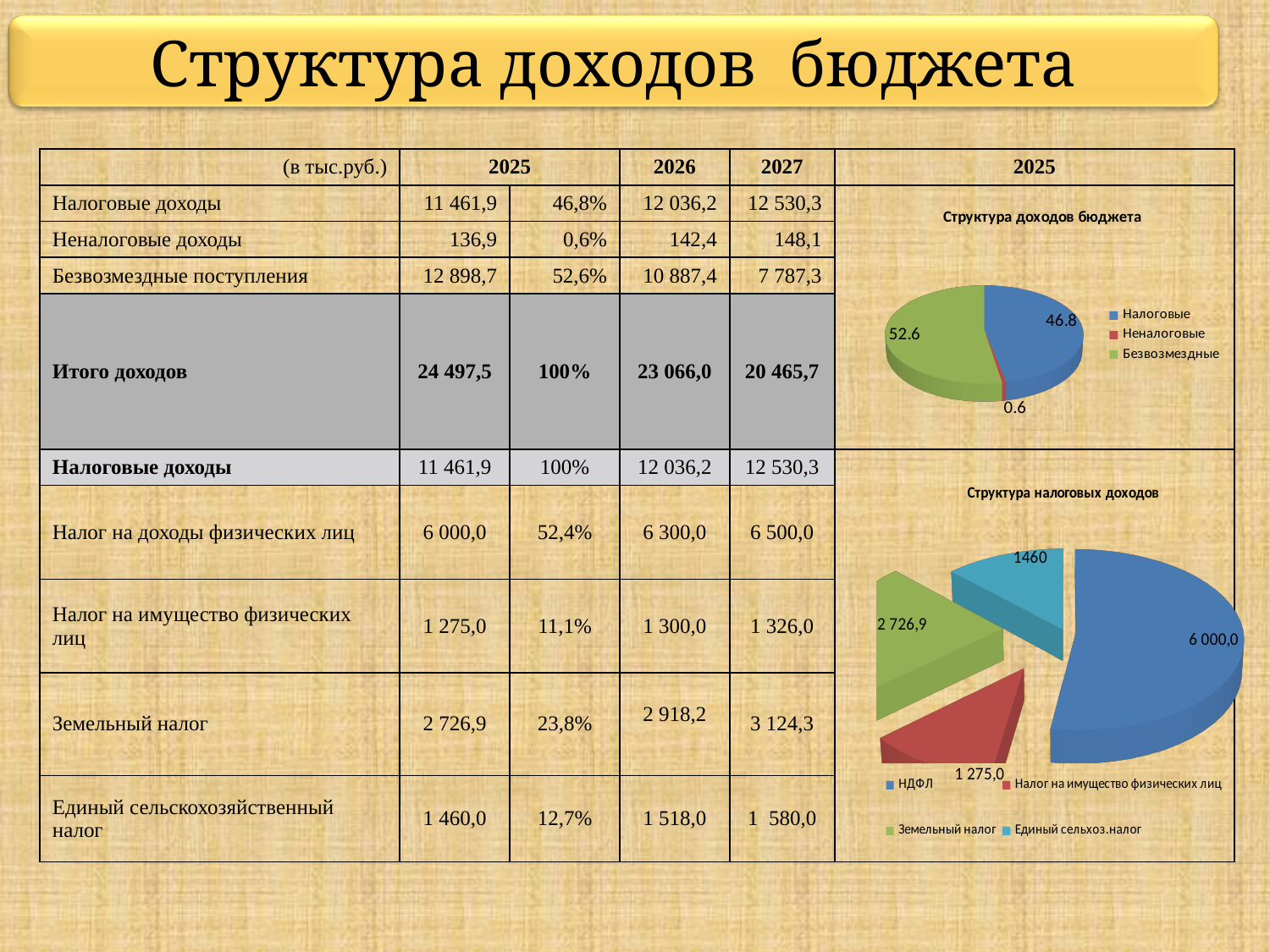
In the "Структура налоговых доходов" chart, what value is shown for the НДФЛ slice? 6 000,0 In the "Структура налоговых доходов" chart, what value is shown for the Земельный налог slice? 2 726,9 In the "Структура налоговых доходов" chart, what value is shown for the Налог на имущество физических лиц slice? 1 275,0 In the "Структура доходов бюджета" chart, what value is shown for the Безвозмездные slice? 52.6 What type of chart is the "Структура доходов бюджета" chart? pie chart In the "Структура доходов бюджета" chart, which slice is the smallest? Неналоговые How many entries does the legend of the "Структура доходов бюджета" chart list? 3 In the "Структура доходов бюджета" chart, which slice is the largest? Безвозмездные In the "Структура доходов бюджета" chart, what value is shown for the Неналоговые slice? 0.6 In the "Структура налоговых доходов" chart, which slice is the largest? НДФЛ In the "Структура доходов бюджета" chart, what value is shown for the Налоговые slice? 46.8 How many slices does the "Структура налоговых доходов" chart have? 4